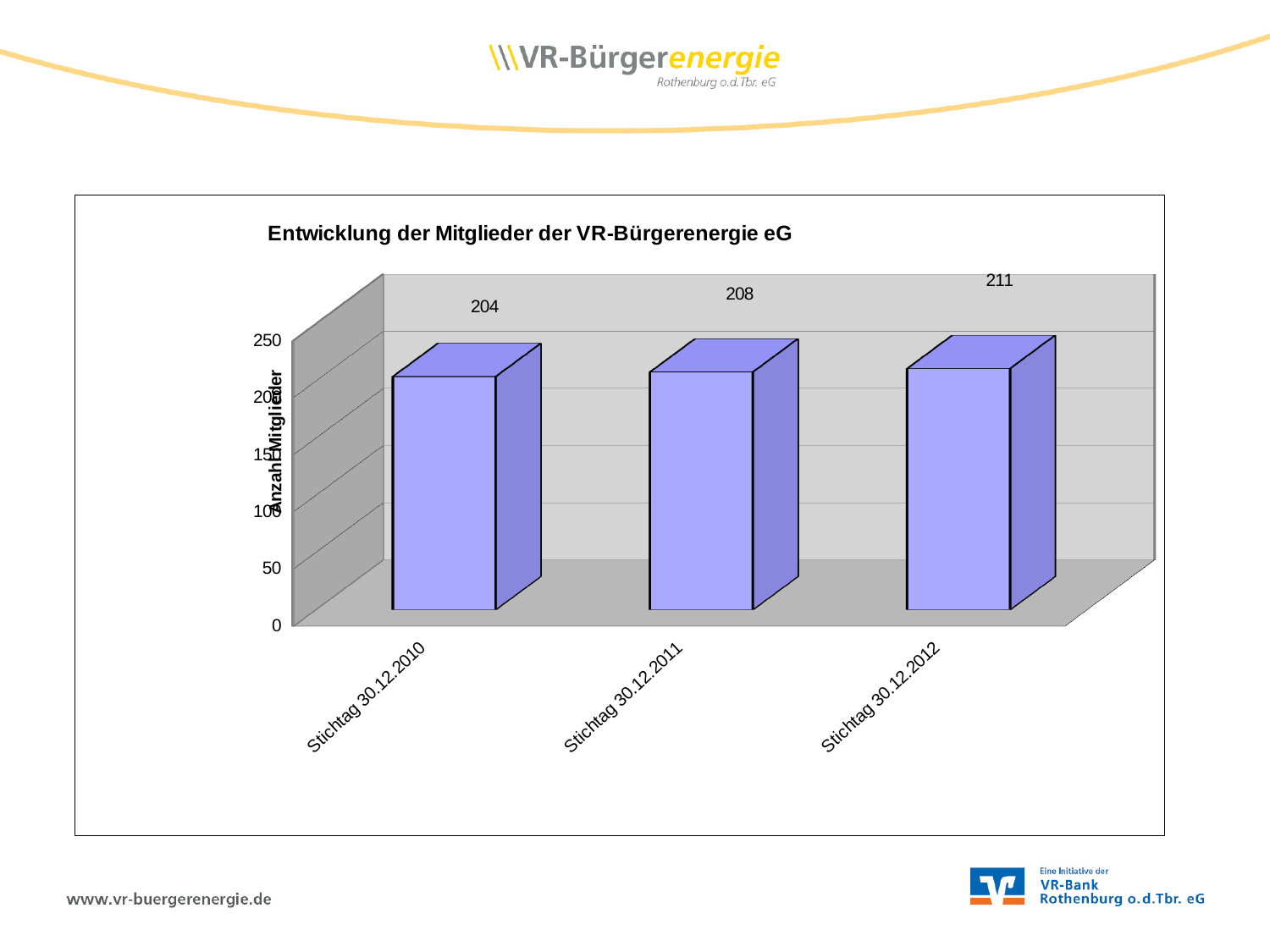
What is the value for Stichtag 30.12.2010? 204 How many categories are shown on the x axis? 3 What kind of chart is shown on the slide? bar chart Which is larger, the value for Stichtag 30.12.2011 or Stichtag 30.12.2012? Stichtag 30.12.2012 Is the value for Stichtag 30.12.2010 greater or less than 250? less Do the values rise or fall from Stichtag 30.12.2010 to Stichtag 30.12.2012? rise What is the value for Stichtag 30.12.2012? 211 Which category has the lowest value? Stichtag 30.12.2010 What is the difference between the values for Stichtag 30.12.2011 and Stichtag 30.12.2010? 4 What is the value for Stichtag 30.12.2011? 208 What is the difference between the values for Stichtag 30.12.2012 and Stichtag 30.12.2010? 7 Which category has the highest value? Stichtag 30.12.2012